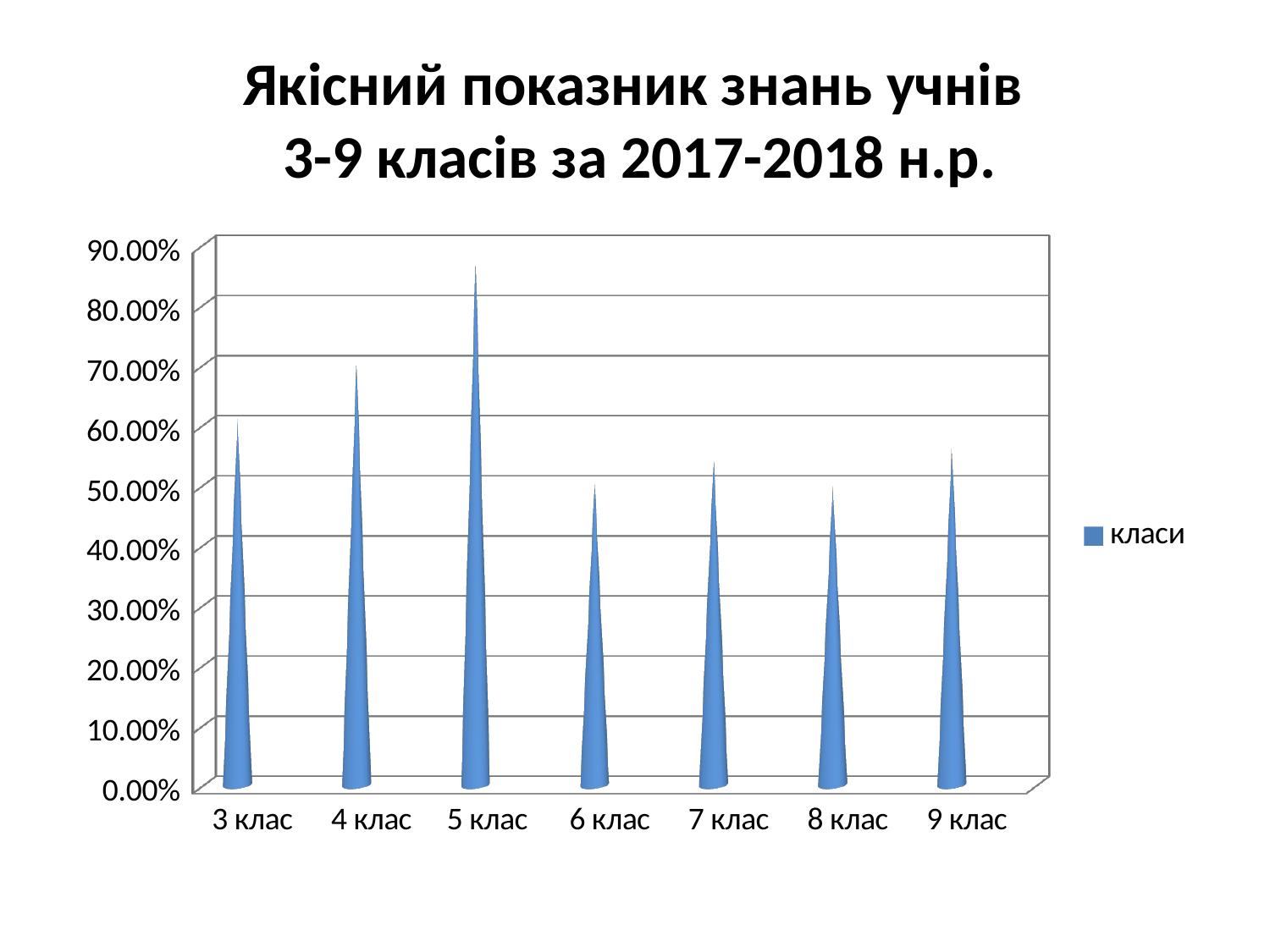
Is the value for 8 клас greater or less than 60.00%? less Is the value for 5 клас greater or less than 80.00%? greater Which is larger, the value for 4 клас or the value for 6 клас? 4 клас How many classes (categories) are shown on the x axis? 7 What kind of chart is shown on the slide? bar chart What is the legend entry for the series? класи Is the value for 6 клас greater or less than 60.00%? less Which class has the highest value? 5 клас Which is larger, the value for 5 клас or the value for 9 клас? 5 клас How many series does the legend list? 1